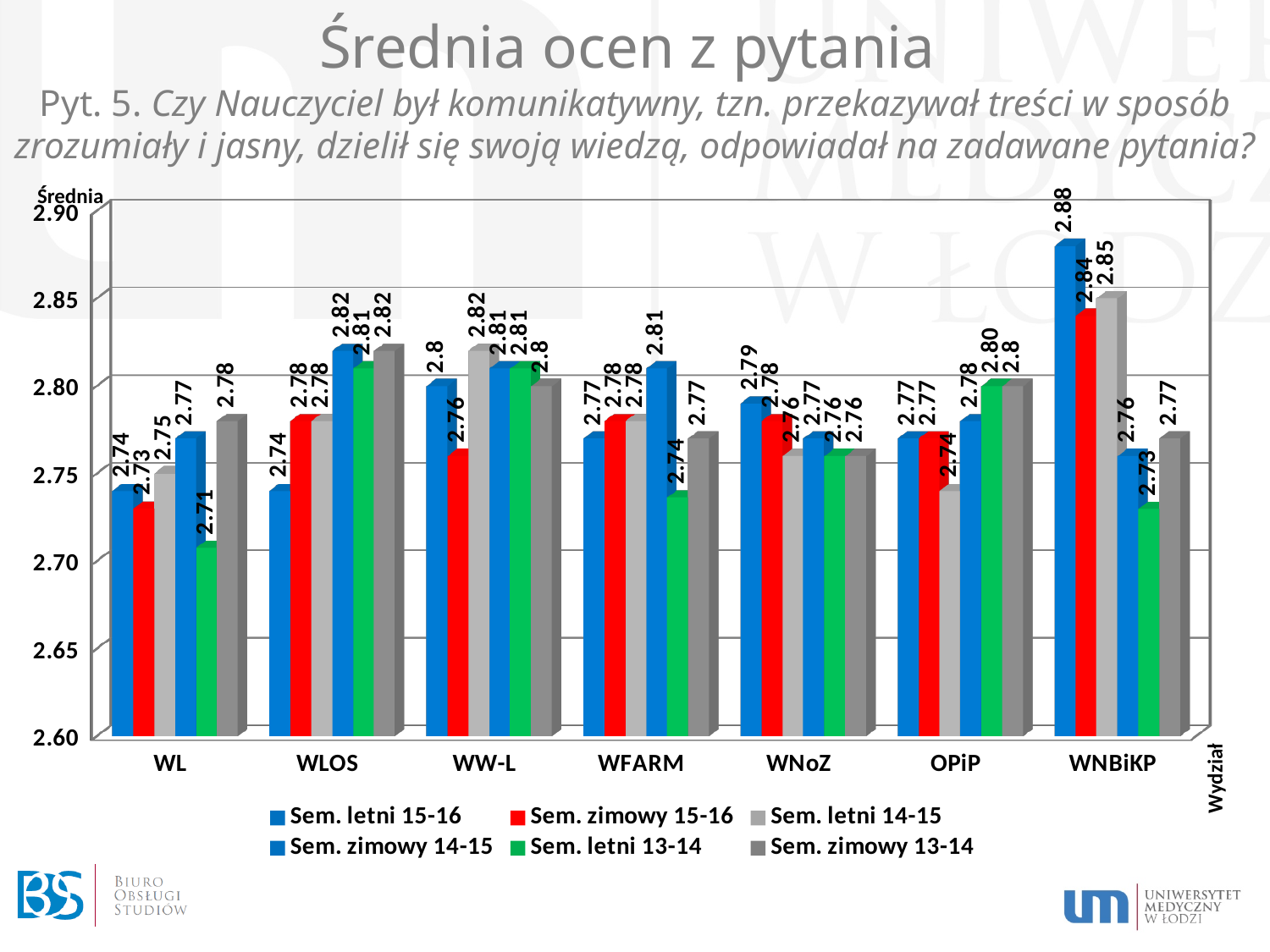
What is the label of the vertical axis? Średnia For Sem. letni 13-14, which is larger: OPiP or WNBiKP? OPiP Which faculty has the highest bar in the chart? WNBiKP What is the value for Sem. letni 14-15 at OPiP? 2.74 What is the value for Sem. zimowy 15-16 at WNBiKP? 2.84 What is the difference between the Sem. zimowy 15-16 values for WNBiKP and WL? 0.11 What is the value for Sem. letni 13-14 at WL? 2.71 What is the lowest value shown in the chart? 2.71 What kind of chart is shown on the slide? Bar chart What is the value for Sem. zimowy 13-14 at WLOS? 2.82 How many faculties are shown on the x axis? 7 How many series does the legend list? 6